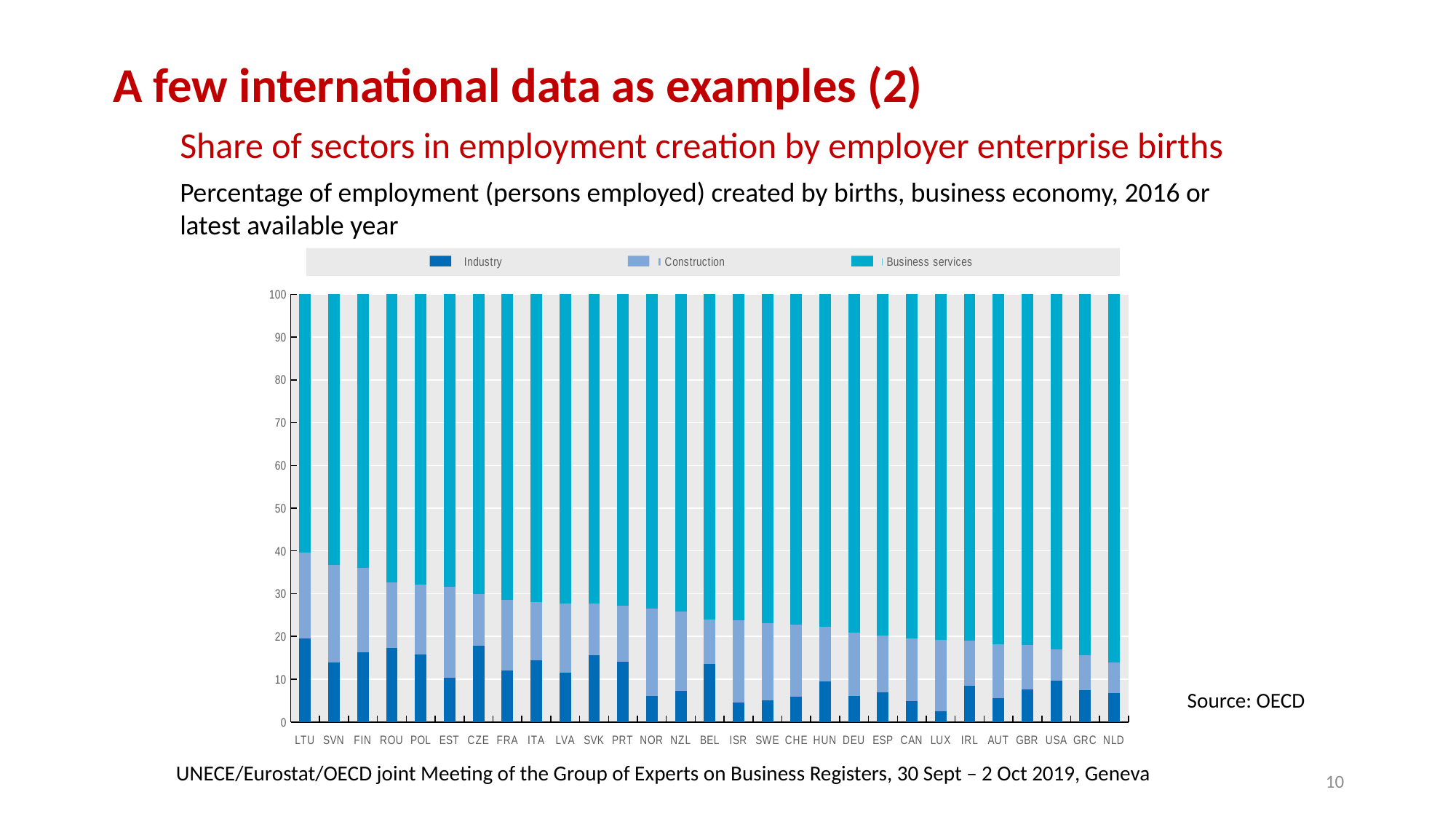
Which has the larger Industry share, LTU or LUX? LTU Is the Business services value for NLD greater or less than 80? greater What is the total of the stacked bar for LTU? 100 Which country has the lowest Industry share? LUX How many series does the legend list? 3 Does the Business services share generally rise or fall moving from left to right along the x axis? rise Which series is shown in the lightest blue (cyan) colour? Business services Is the Industry value for LTU greater or less than 10? greater What kind of chart is shown on the slide? Stacked bar chart Which country has the highest Business services share? NLD Is the Industry value for LUX greater or less than 10? less How many countries are shown on the x axis? 29